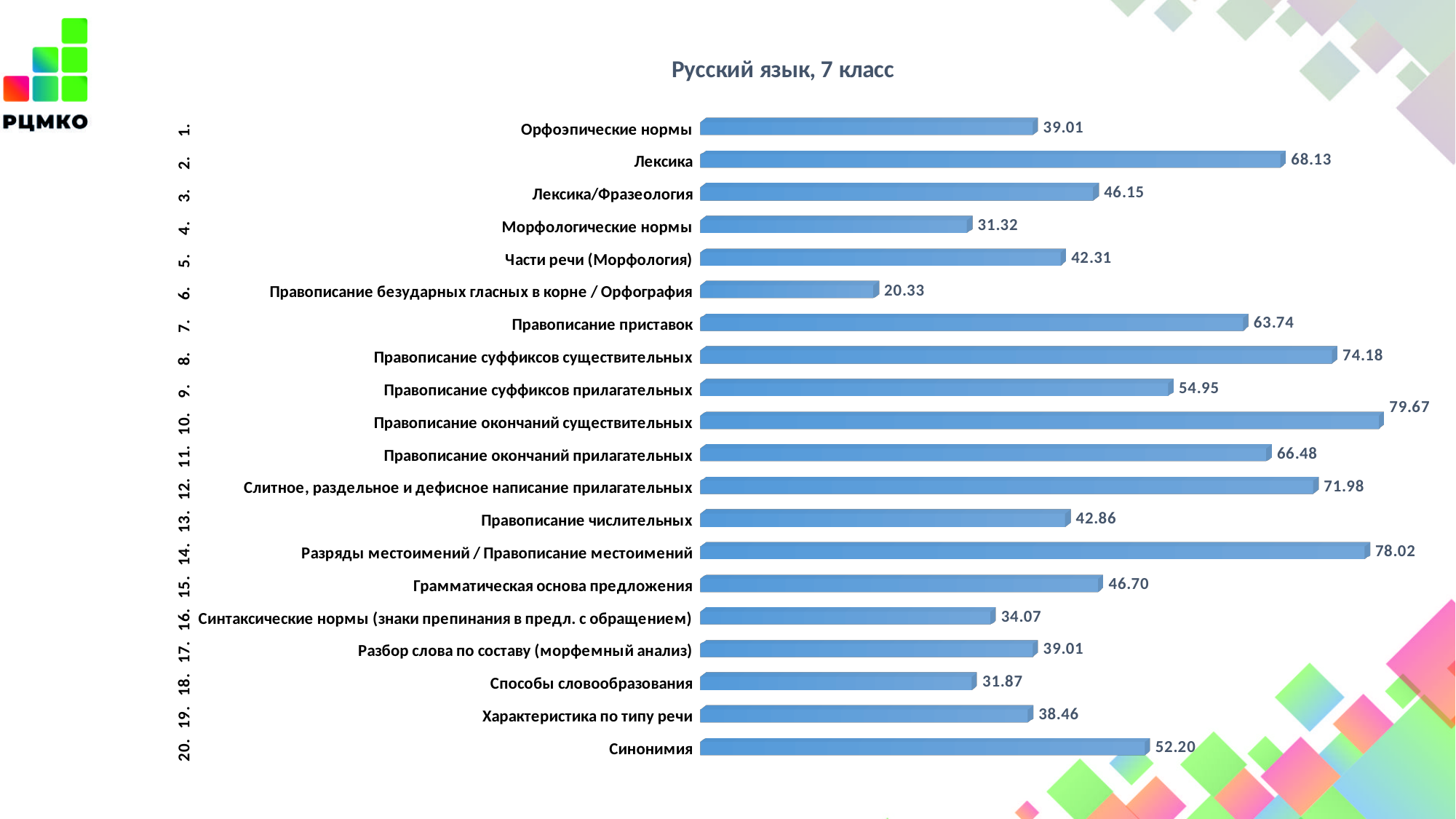
Which is larger: the value for Правописание суффиксов существительных or the value for Правописание суффиксов прилагательных? Правописание суффиксов существительных What kind of chart is shown on the slide? Bar chart Which category has the lowest value? Правописание безударных гласных в корне / Орфография What is the difference between the values for Лексика and Орфоэпические нормы? 29.12 What is the title of the chart? Русский язык, 7 класс Which category has the highest value? Правописание окончаний существительных What is the value for Правописание приставок? 63.74 What is the difference between the values for Синонимия and Способы словообразования? 20.33 What is the value for Синонимия? 52.20 What is the value for Лексика? 68.13 How many categories are shown in the chart? 20 What is the value for Правописание безударных гласных в корне / Орфография? 20.33